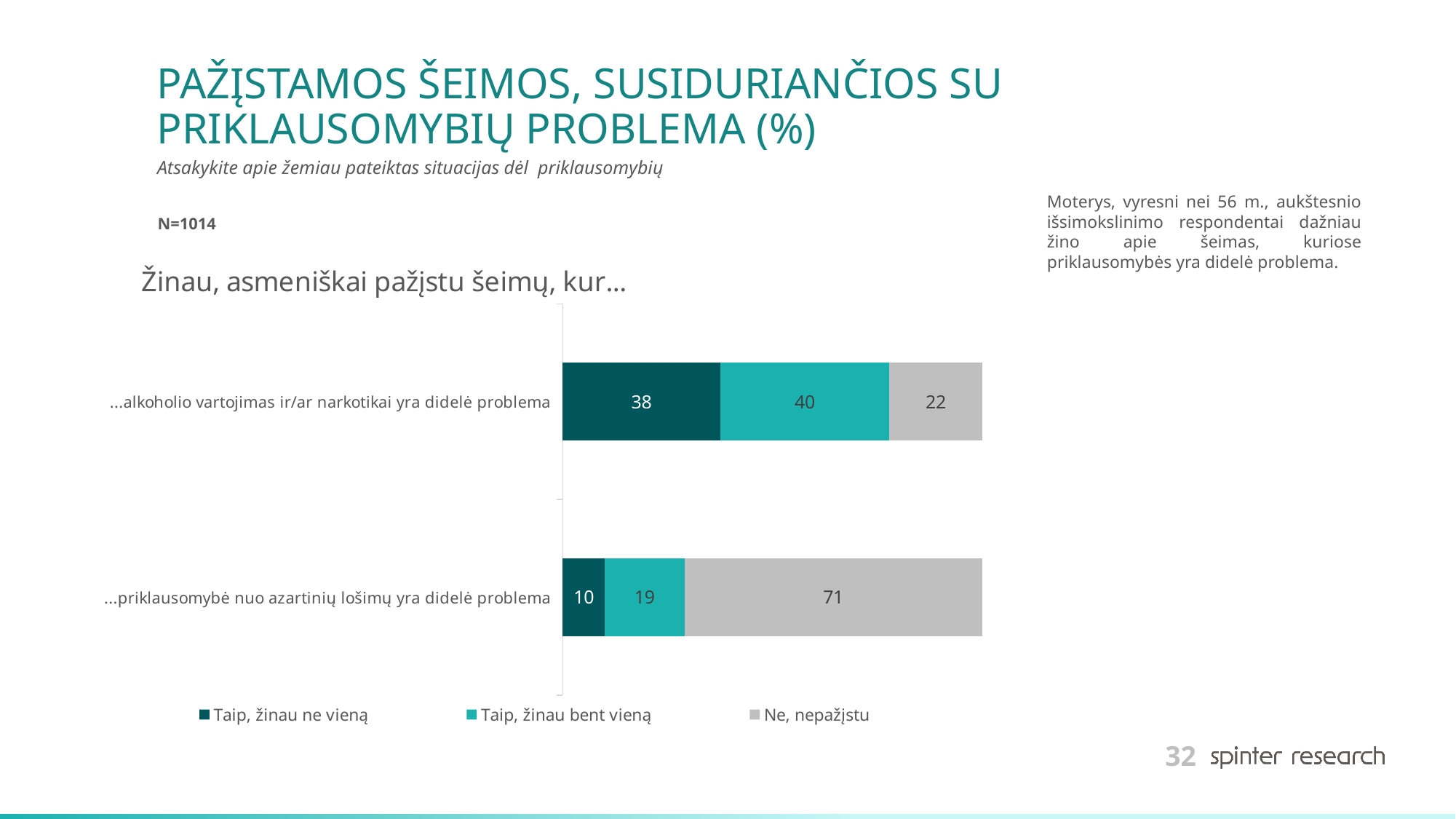
How many series does the legend list? 3 What is the difference between the "Ne, nepažįstu" values for the two categories? 49 Which is larger for "...alkoholio vartojimas ir/ar narkotikai yra didelė problema": "Taip, žinau ne vieną" or "Taip, žinau bent vieną"? Taip, žinau bent vieną What is the value of "Taip, žinau bent vieną" for "...priklausomybė nuo azartinių lošimų yra didelė problema"? 19 How many categories are plotted in the chart? 2 What is the value of "Ne, nepažįstu" for "...priklausomybė nuo azartinių lošimų yra didelė problema"? 71 Which category has the lowest value for "Taip, žinau ne vieną"? ...priklausomybė nuo azartinių lošimų yra didelė problema What is the title of the chart? Žinau, asmeniškai pažįstu šeimų, kur… Which category has the highest value for "Ne, nepažįstu"? ...priklausomybė nuo azartinių lošimų yra didelė problema What is the value of "Taip, žinau ne vieną" for "...alkoholio vartojimas ir/ar narkotikai yra didelė problema"? 38 What kind of chart is shown on the slide? Stacked bar chart What is the total of the stacked bar for "...alkoholio vartojimas ir/ar narkotikai yra didelė problema"? 100